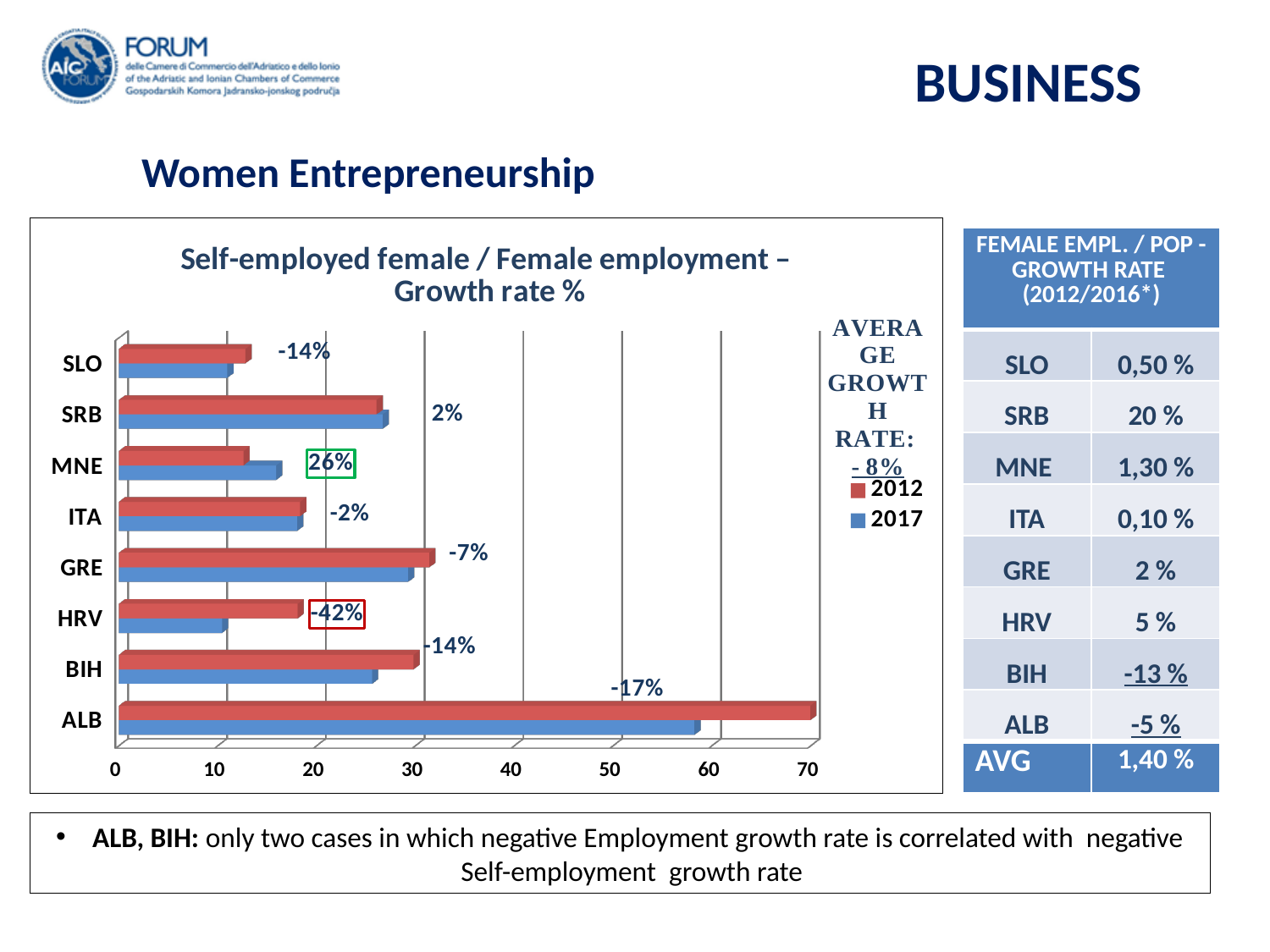
What is the average growth rate stated on the chart? -8% How many countries are shown on the chart's vertical axis? 8 Which country has the highest labelled growth rate on the chart? MNE What growth rate is labelled for HRV on the chart? -42% How many series does the chart legend list? 2 Which years are listed in the chart legend? 2012 and 2017 What growth rate is labelled for ALB on the chart? -17% Which country has the lowest labelled growth rate on the chart? HRV What growth rate is labelled for MNE on the chart? 26% What kind of chart is shown on the left of the slide? bar chart Which country has the longest bars in the chart? ALB What is the title of the bar chart on the slide? Self-employed female / Female employment – Growth rate %